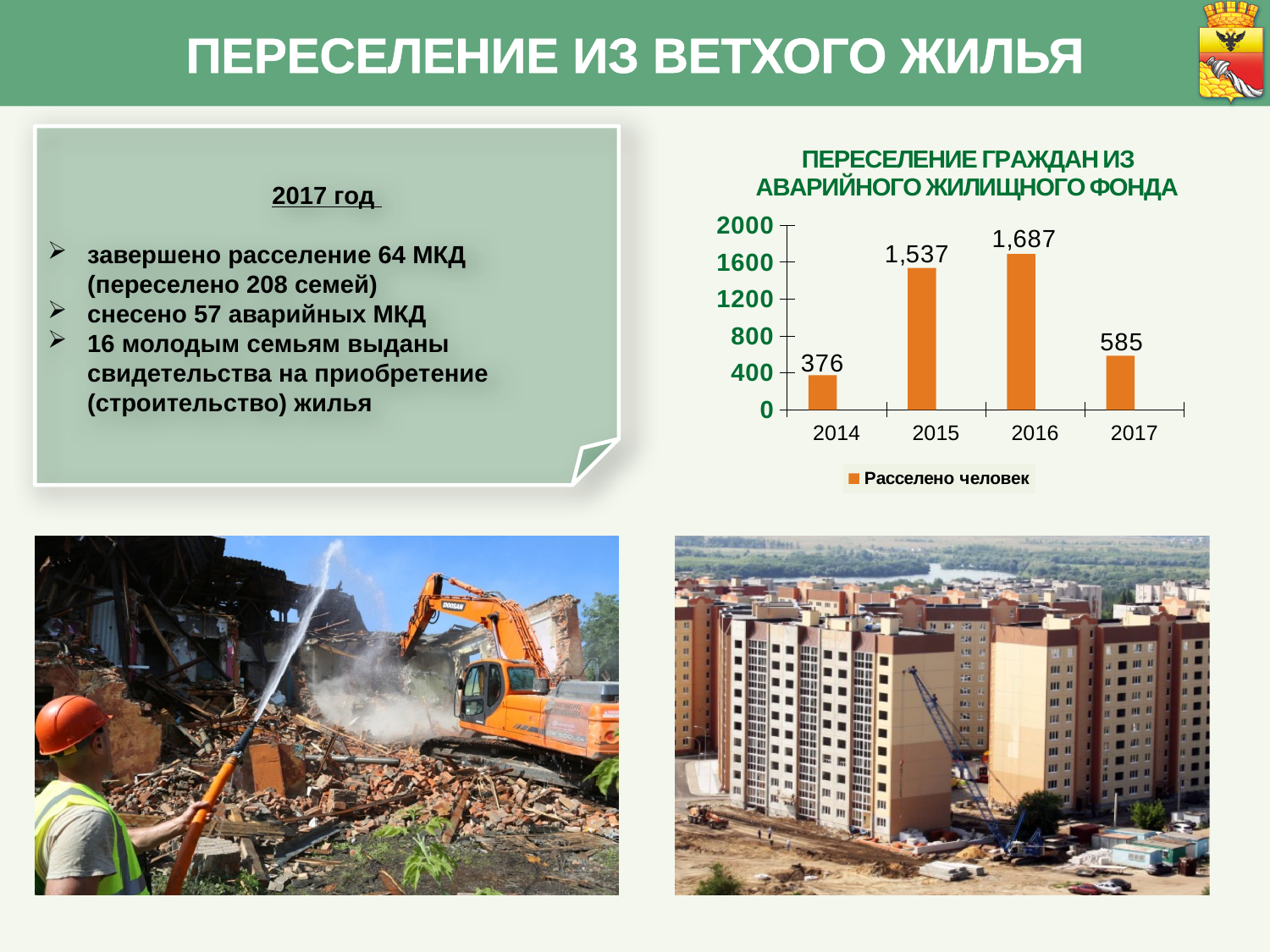
How many people were resettled in 2015 according to the chart? 1,537 How many years are shown on the x axis of the chart? 4 What kind of chart is shown on the slide? bar chart Which year has the lowest number of resettled people? 2014 What is the difference between the values for 2016 and 2015? 150 Which is larger, the value for 2015 or the value for 2017? 2015 Is the value for 2016 greater or less than 1600? greater Which year has the highest number of resettled people? 2016 What is the difference between the values for 2017 and 2014? 209 What is the value shown for 2017 in the chart? 585 What is the legend entry of the chart? Расселено человек What is the value shown for 2014 in the chart? 376